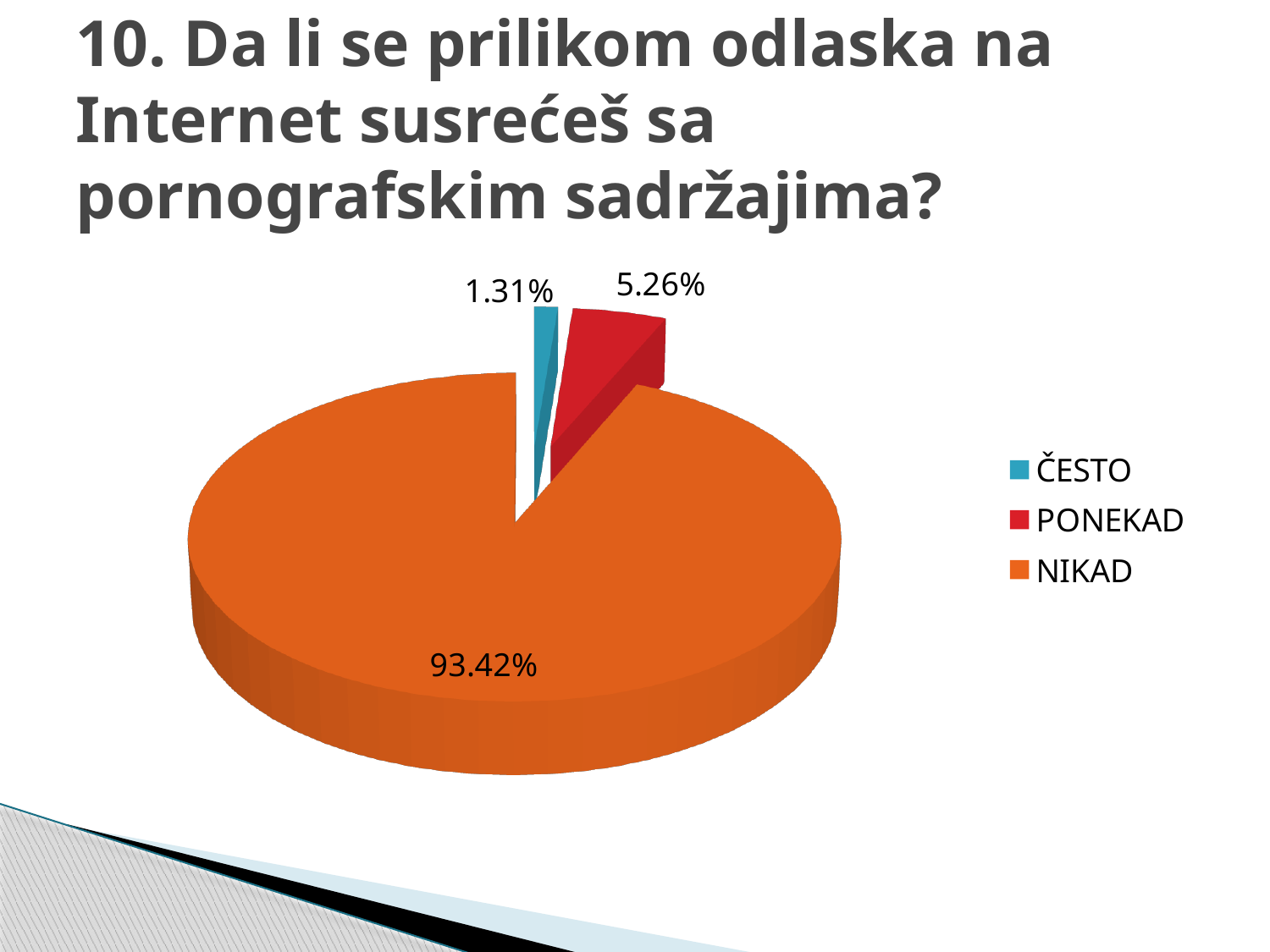
Which is larger, the share for PONEKAD or the share for ČESTO? PONEKAD What percentage is shown for PONEKAD? 5.26% What is the difference in percentage points between NIKAD and PONEKAD? 88.16 How many categories does the legend list? 3 What percentage is shown for NIKAD? 93.42% What is the difference in percentage points between PONEKAD and ČESTO? 3.95 Which category has the smallest share of the pie? ČESTO Which category has the largest share of the pie? NIKAD What colour is the NIKAD slice? orange What percentage is shown for ČESTO? 1.31% What kind of chart is shown on the slide? pie chart Which legend entry is shown in red? PONEKAD